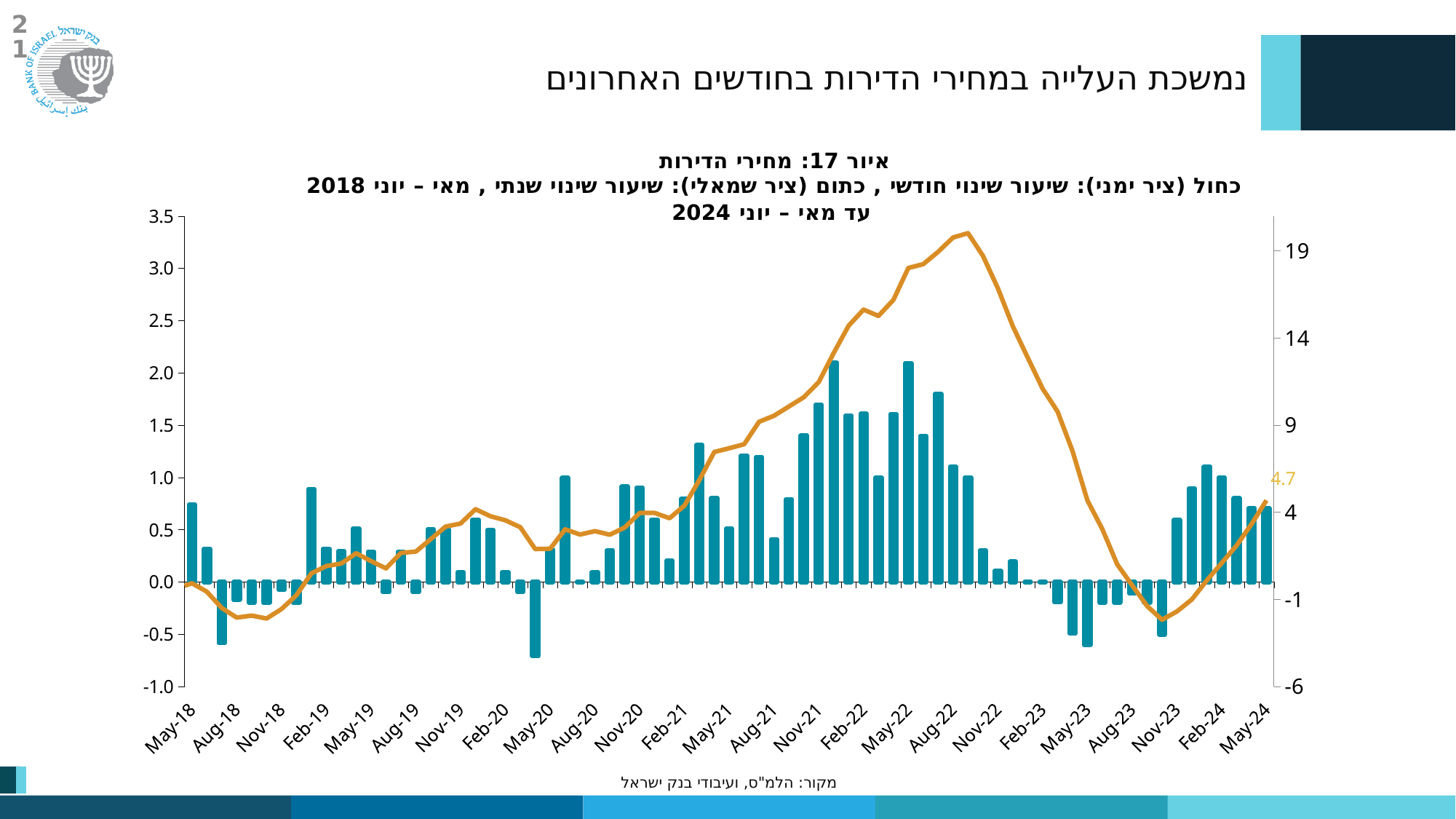
What kind of chart is shown on the slide? A combined bar and line chart Is the tallest blue bar (around Dec-21) greater or less than 1.5 on the left axis? greater Does the orange line rise or fall between Aug-22 and Aug-23? Falls How many data series are plotted on the chart? 2 Is the orange line value at Aug-23 greater or less than 4 on the right axis? less What value is printed as a data label at the end of the orange line? 4.7 What colour is the line series on the chart? Orange Does the orange line rise or fall between Nov-23 and May-24? Rises What is the figure number and title of the chart? איור 17: מחירי הדירות Which is higher on the orange line: the value at Aug-22 or the value at Aug-23? Aug-22 Is the blue bar at May-20 greater or less than -0.5 on the left axis? greater